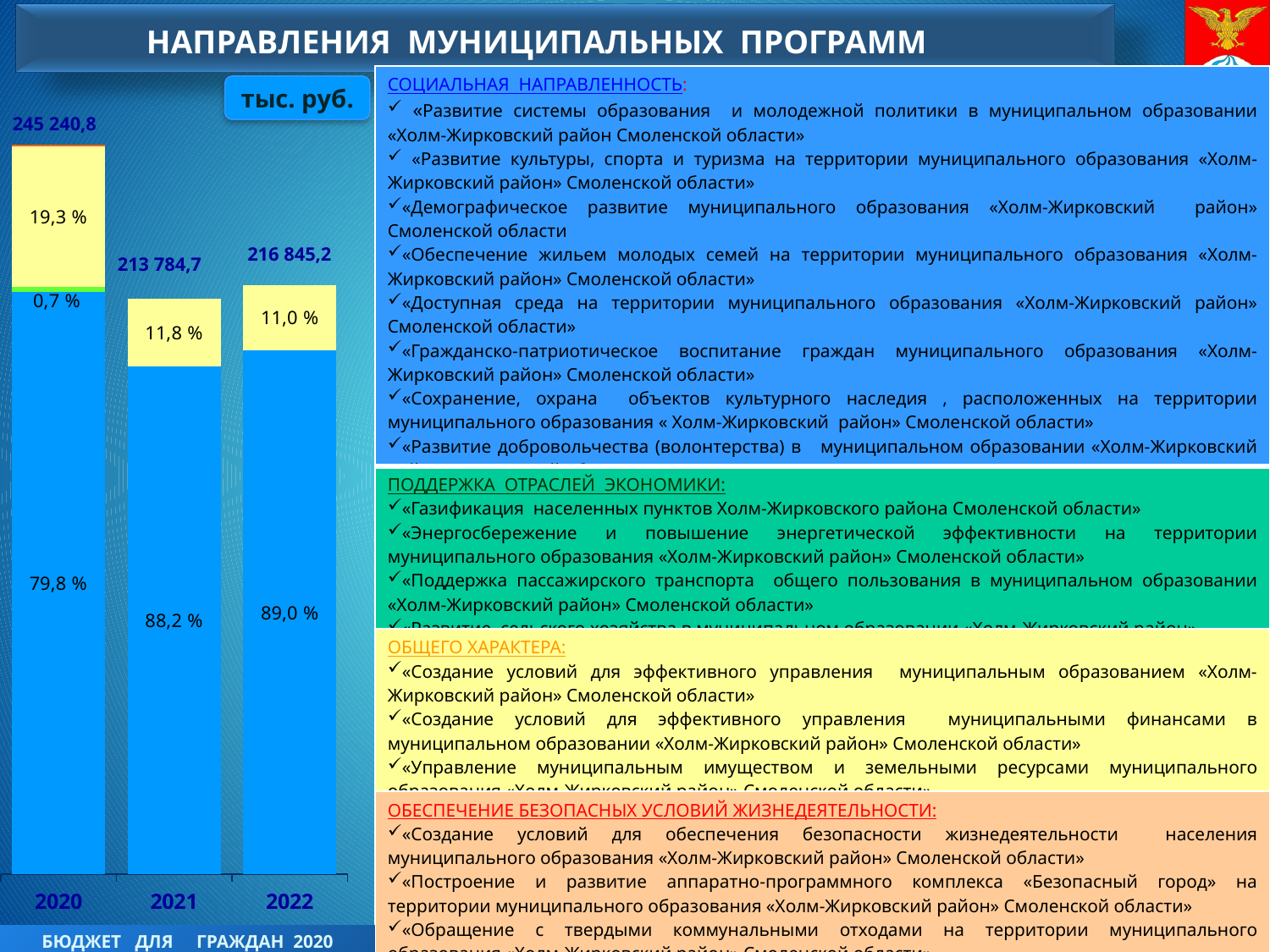
What percentage is labelled on the blue segment of the 2022 bar? 89,0 % What is the total value shown above the bar for 2022? 216 845,2 Is the total for 2022 larger or smaller than the total for 2021? larger What is the total value shown above the bar for 2020? 245 240,8 How many years (bars) are shown in the chart? 3 What percentage is labelled on the green segment of the 2020 bar? 0,7 % Which year has the highest total value? 2020 What unit is indicated for the chart values? тыс. руб. What is the total value shown above the bar for 2021? 213 784,7 What percentage is labelled on the yellow segment of the 2021 bar? 11,8 % Which year has the lowest total value? 2021 What percentage is labelled on the blue segment of the 2020 bar? 79,8 %